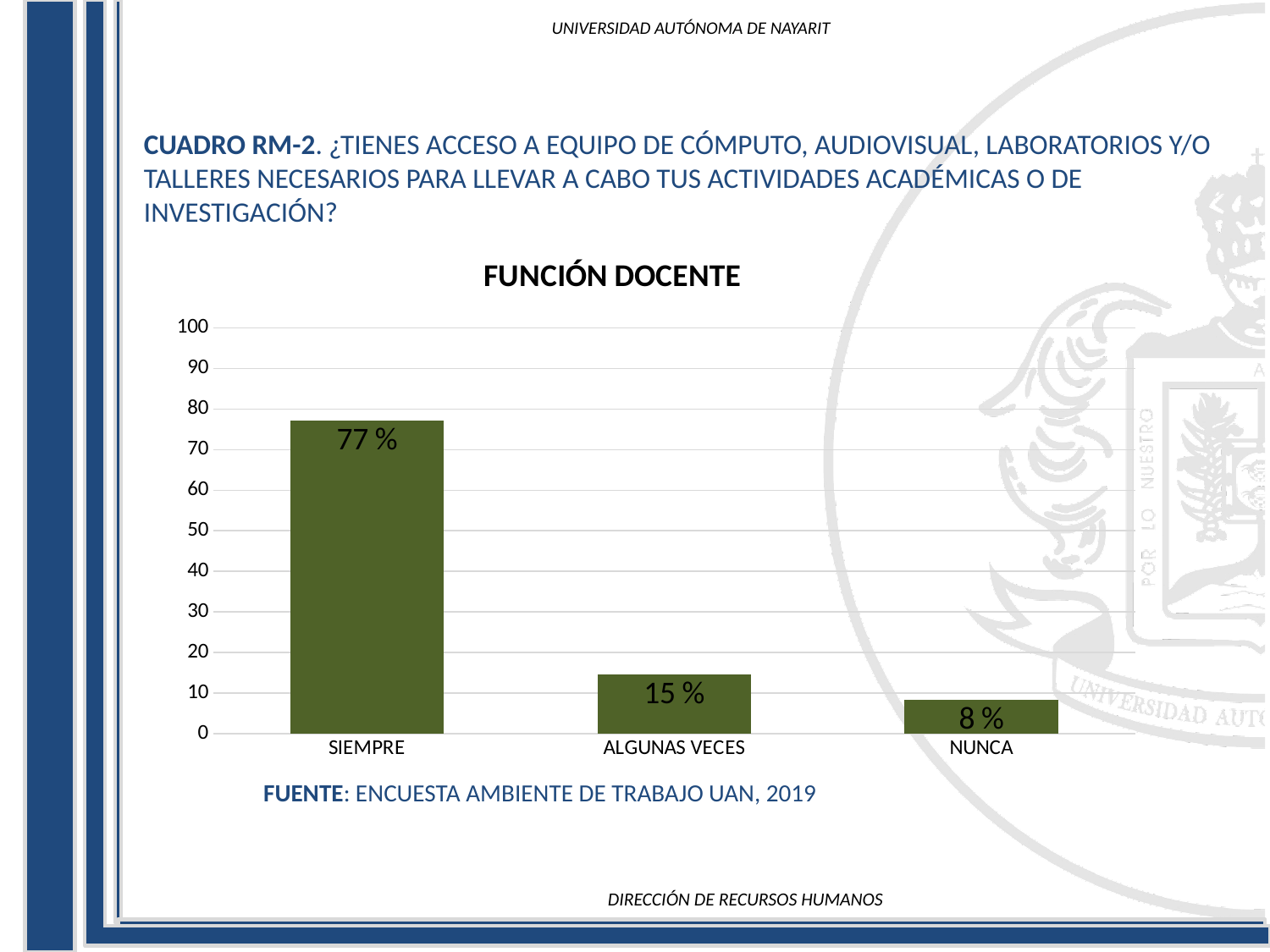
What is the difference between the values for SIEMPRE and ALGUNAS VECES? 62 % Which category has the highest value? SIEMPRE Is the value for SIEMPRE greater or less than 70? greater What is the value for SIEMPRE? 77 % How many categories are shown on the x axis? 3 What is the value for ALGUNAS VECES? 15 % What is the difference between the values for ALGUNAS VECES and NUNCA? 7 % Which is larger, the value for ALGUNAS VECES or the value for NUNCA? ALGUNAS VECES What is the title of the chart? FUNCIÓN DOCENTE What is the value for NUNCA? 8 % Which category has the lowest value? NUNCA What kind of chart is shown? bar chart